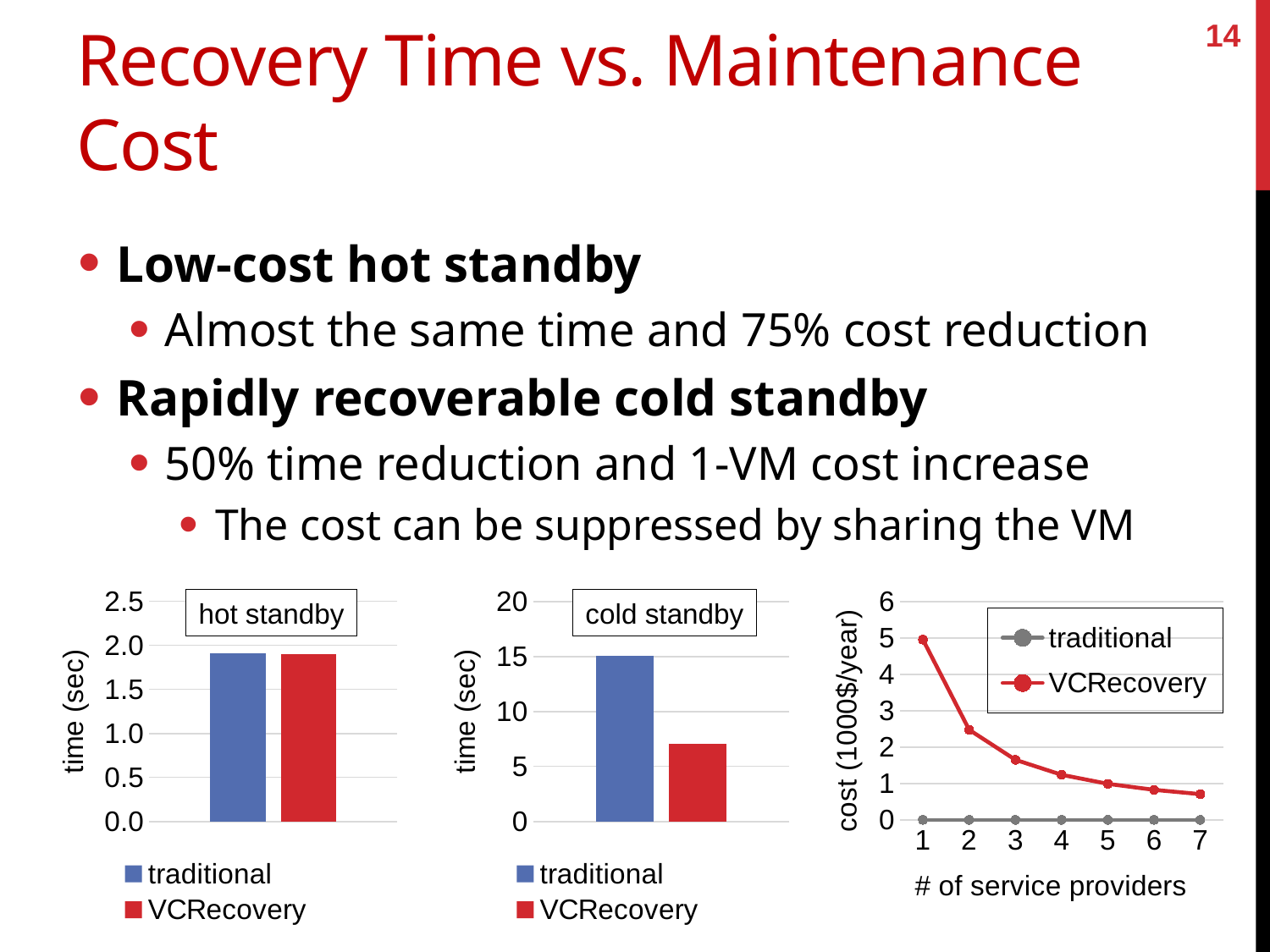
In the hot standby chart, what type of chart is shown? bar chart In the cold standby chart, what is the time for traditional? 15 In the cold standby chart, which series has the lower time? VCRecovery In the hot standby chart, how many series does the legend list? 2 In the hot standby chart, is the value for traditional greater or less than 1.5? greater In the cold standby chart, is the value for VCRecovery greater or less than 10? less In the line chart on the right, does the VCRecovery cost rise or fall as the number of service providers increases? fall In the line chart on the right, what type of chart is shown? line chart In the cold standby chart, what is the label of the y axis? time (sec) In the hot standby chart, is the value for VCRecovery greater or less than 2.0? less In the line chart on the right, how many points are plotted along the x axis for each series? 7